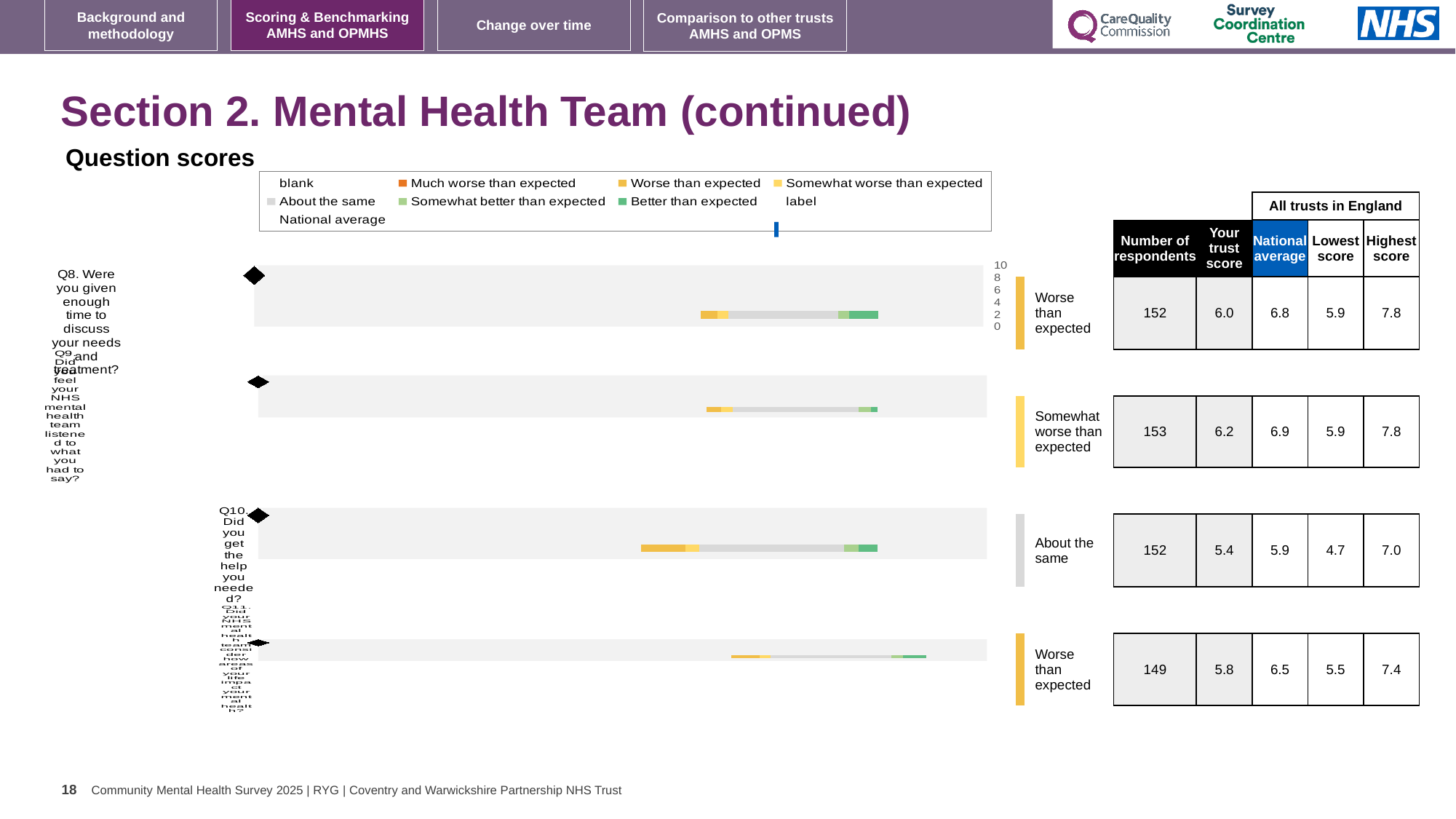
Which question has the highest 'Your trust score'? Q9 How many questions (rows) are plotted in the question scores chart? 4 What is the 'Your trust score' for Q8 in the table beside the chart? 6.0 For Q11, which is larger: the trust score or the national average? National average What is the heading above the chart? Question scores What is the national average for Q9 in the table beside the chart? 6.9 What is the highest score across all trusts in England for Q10? 7.0 How many respondents are listed for Q11? 149 What kind of chart is used to show the question scores? bar chart What benchmark category label is shown next to the Q10 bar? About the same Which question has the lowest 'Your trust score'? Q10 For Q8, what is the difference between the national average and the trust score? 0.8